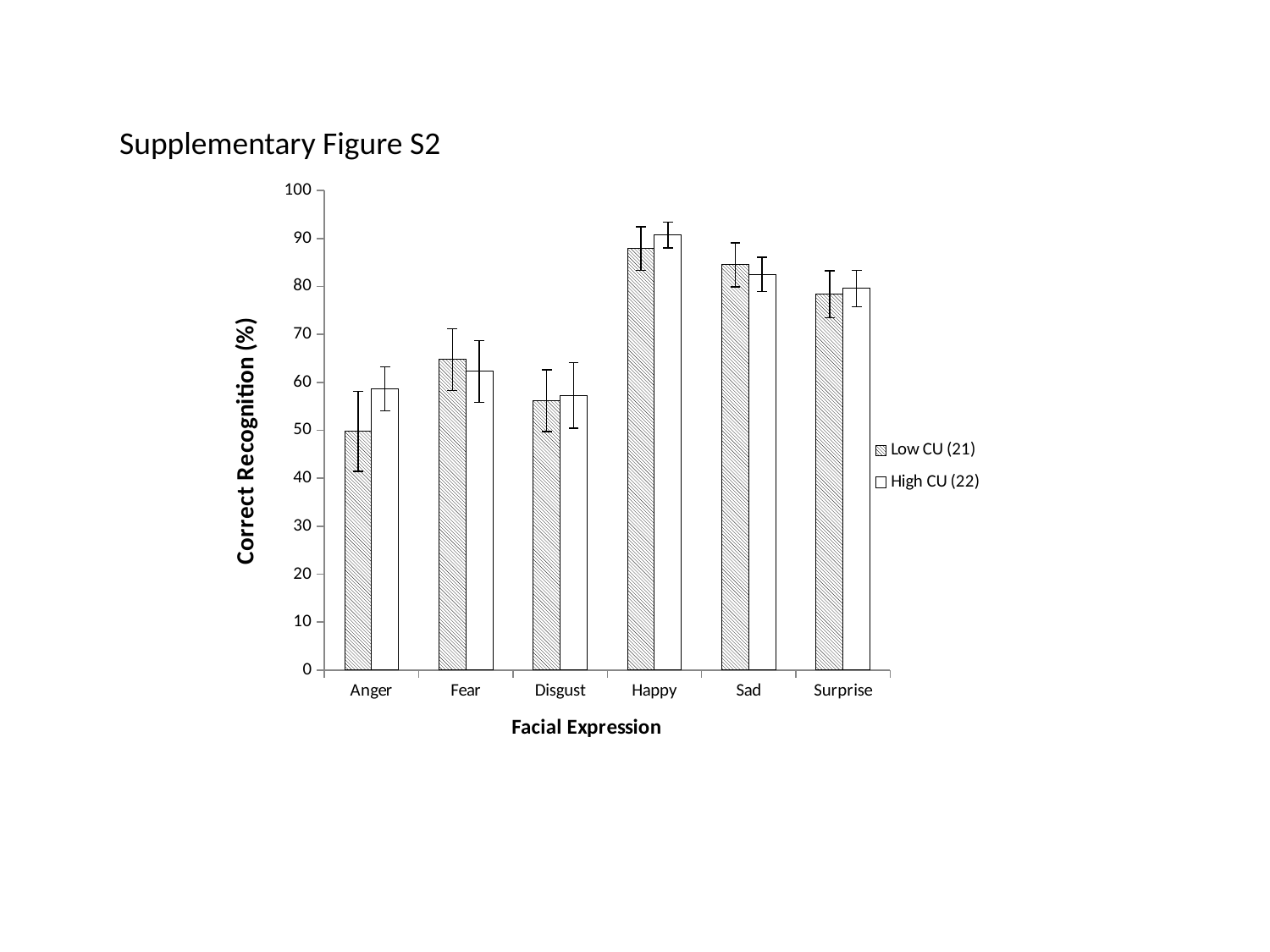
Is the Low CU (21) value for Fear greater or less than 60? greater Which facial expression has the lowest correct recognition for the Low CU (21) group? Anger Which facial expression has the lowest correct recognition for the High CU (22) group? Anger Which facial expression has the highest correct recognition for the Low CU (21) group? Happy How many facial expression categories are shown on the x axis? 6 Is the Low CU (21) value for Disgust greater or less than 60? less What kind of chart is shown on the slide? bar chart For Anger, which group has the higher correct recognition, Low CU (21) or High CU (22)? High CU (22) How many series does the legend list? 2 For the Low CU (21) group, which is higher, Happy or Sad? Happy Is the Low CU (21) value for Happy greater or less than 80? greater What is the label of the y axis? Correct Recognition (%)